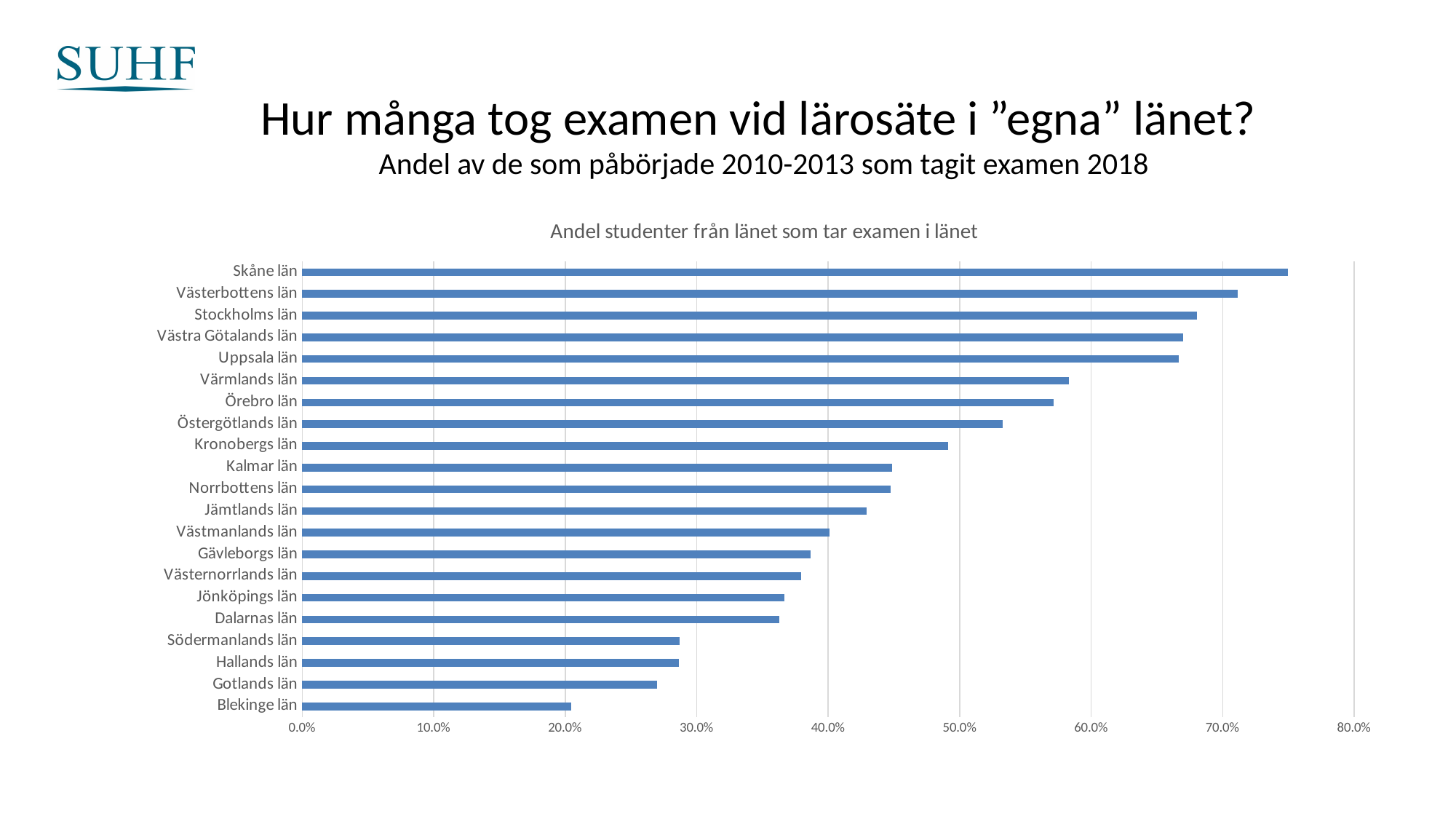
Which has a larger value, Stockholms län or Örebro län? Stockholms län Is the value for Kronobergs län greater or less than 50%? less Which county has the lowest share of students taking their degree in the county? Blekinge län Which county has the highest share of students taking their degree in the county? Skåne län Is the value for Skåne län greater or less than 70%? greater Which has a larger value, Hallands län or Jämtlands län? Jämtlands län How many counties are shown in the chart? 21 Is the value for Värmlands län greater or less than 50%? greater What kind of chart is shown on the slide? bar chart What is the title of the chart? Andel studenter från länet som tar examen i länet